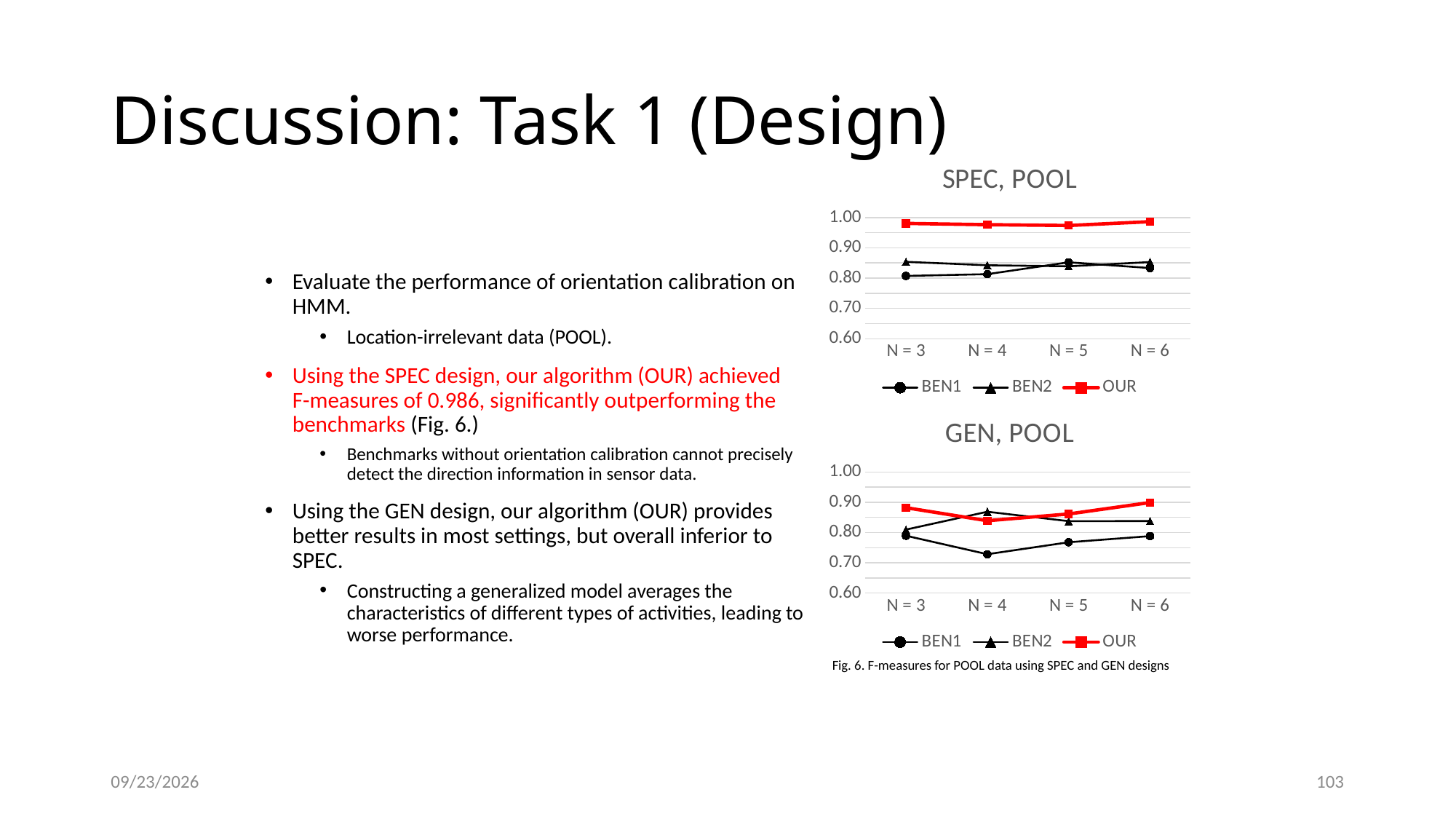
In the "SPEC, POOL" chart, is the value of OUR at N = 3 greater or less than 0.90? greater How many series does the legend of the "GEN, POOL" chart list? 3 What type of chart is the "SPEC, POOL" chart? line chart What is the title of the lower chart on the slide? GEN, POOL In the "GEN, POOL" chart, is the value of BEN1 at N = 4 greater or less than 0.80? less How many N settings are plotted along the x axis of the "SPEC, POOL" chart? 4 Which series is drawn in red in the "SPEC, POOL" chart? OUR In the "SPEC, POOL" chart, is the value of BEN1 at N = 3 greater or less than 0.90? less In the "SPEC, POOL" chart, which series has the highest value at N = 5? OUR In the "GEN, POOL" chart, which series has the lowest value at N = 4? BEN1 In the "GEN, POOL" chart, which is larger at N = 3: BEN2 or OUR? OUR In the "GEN, POOL" chart, does the BEN1 series rise or fall from N = 4 to N = 6? rise